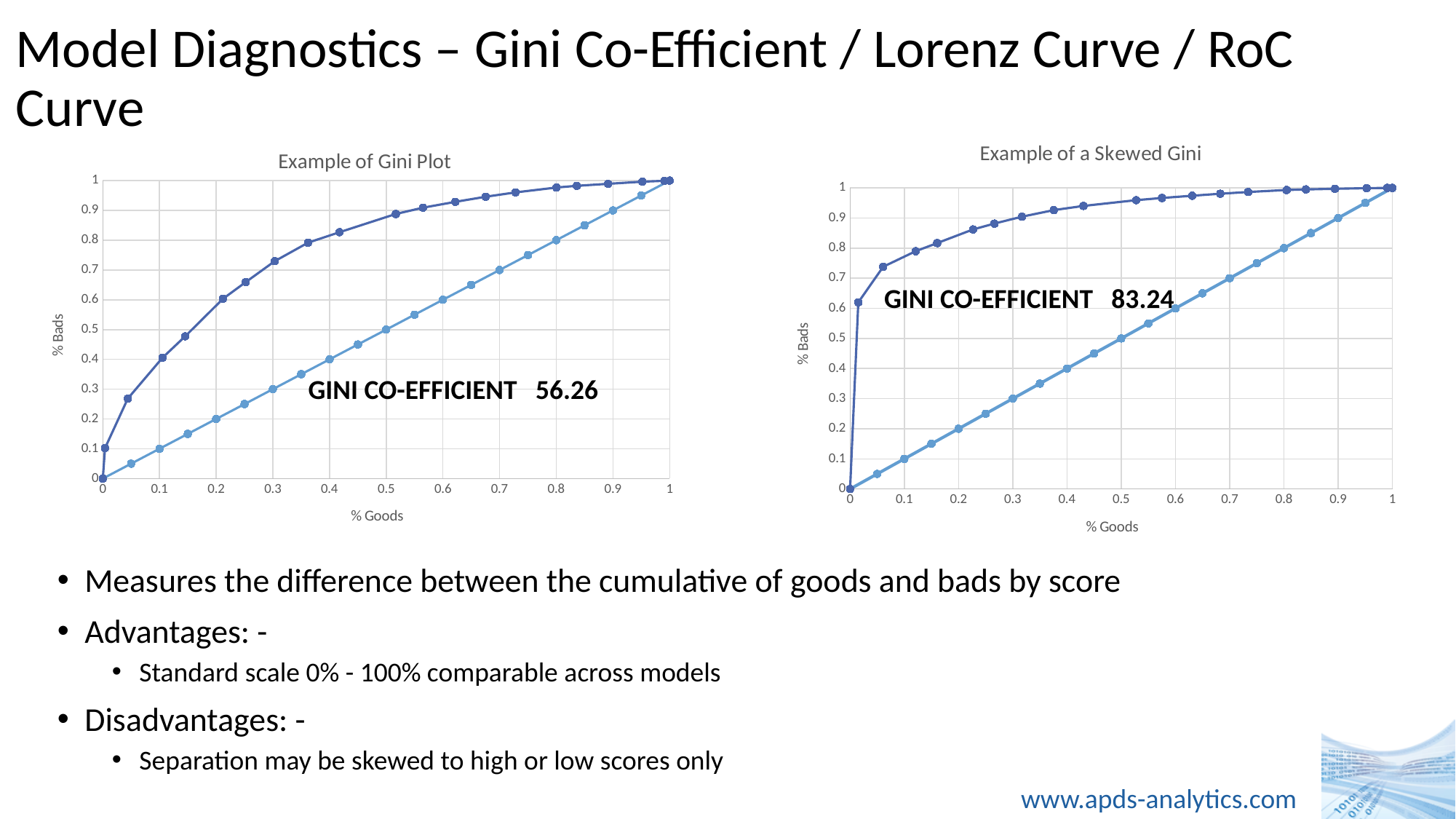
What is the title of the chart on the right? Example of a Skewed Gini What kind of chart is the 'Example of Gini Plot' on the left? line chart In the 'Example of a Skewed Gini' chart, is the value of the dark blue curve at % Goods = 0.1 greater or less than 0.7? greater In the 'Example of Gini Plot' chart, at % Goods = 0.3, which line is higher, the dark blue curve or the light blue straight line? the dark blue curve In the 'Example of Gini Plot' chart, does the dark blue curve rise or fall as % Goods increases? rise In the 'Example of Gini Plot' chart, is the value of the dark blue curve at % Goods = 0.5 greater or less than 0.8? greater Which chart shows the higher Gini co-efficient, 'Example of Gini Plot' or 'Example of a Skewed Gini'? Example of a Skewed Gini In the 'Example of a Skewed Gini' chart, what Gini co-efficient value is printed on the chart? 83.24 What is the label of the x axis on the 'Example of Gini Plot' chart? % Goods What is the difference between the Gini co-efficient printed on the 'Example of a Skewed Gini' chart and the one printed on the 'Example of Gini Plot' chart? 26.98 How many lines are plotted on the 'Example of a Skewed Gini' chart? 2 In the 'Example of Gini Plot' chart, what Gini co-efficient value is printed on the chart? 56.26